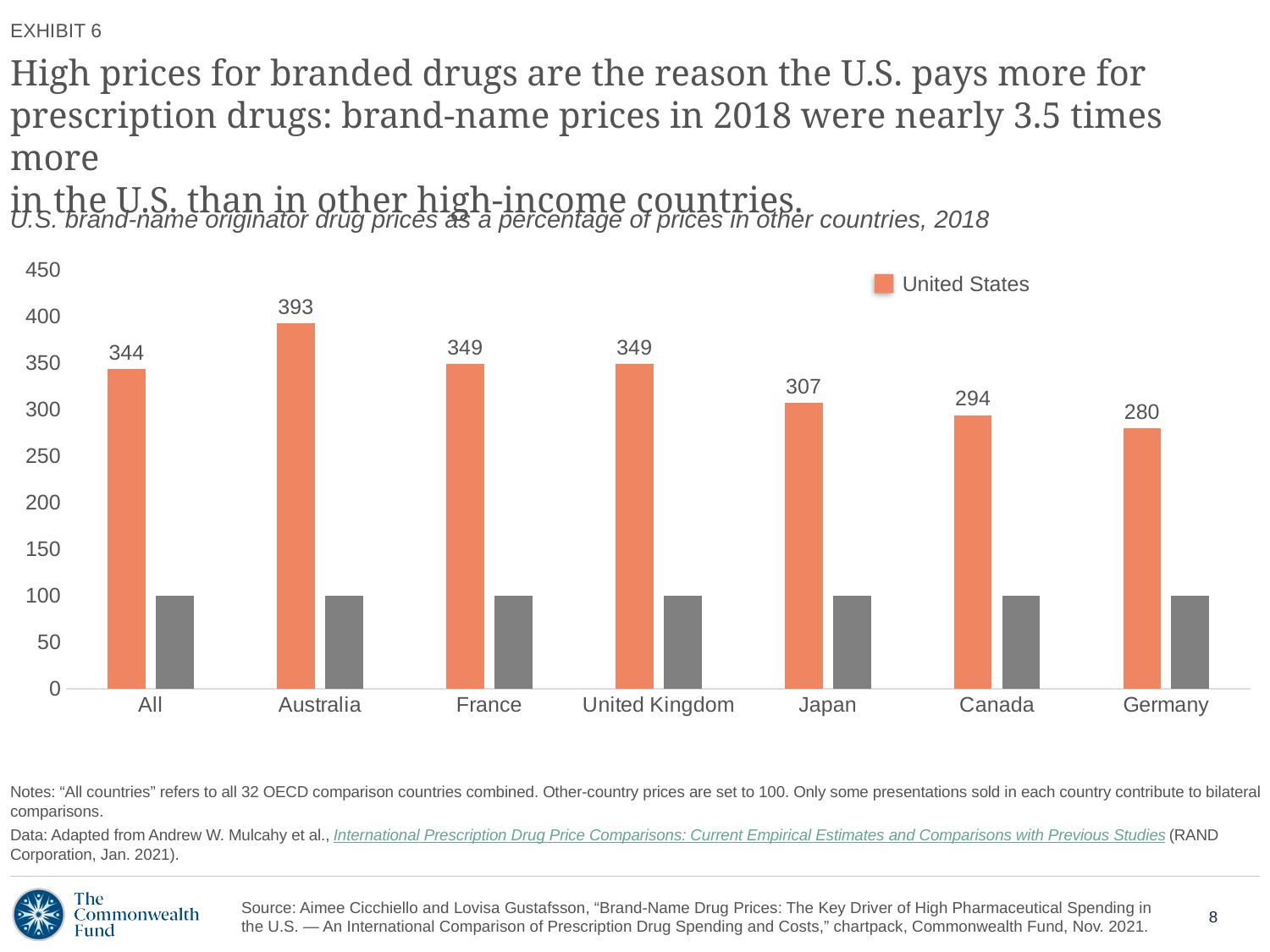
How many series does the legend list? 1 What is the United States value for Japan? 307 Which country has the lowest United States value? Germany Which has a larger United States value, Japan or Canada? Japan What is the United States value for the 'All' category? 344 How many categories are shown on the x axis? 7 Which country has the highest United States value? Australia What kind of chart is shown on the slide? Bar chart What is the United States value for Australia? 393 What is the United States value for Germany? 280 Is the gray bar for France greater or less than 150? less What is the difference between the United States values for Australia and Germany? 113